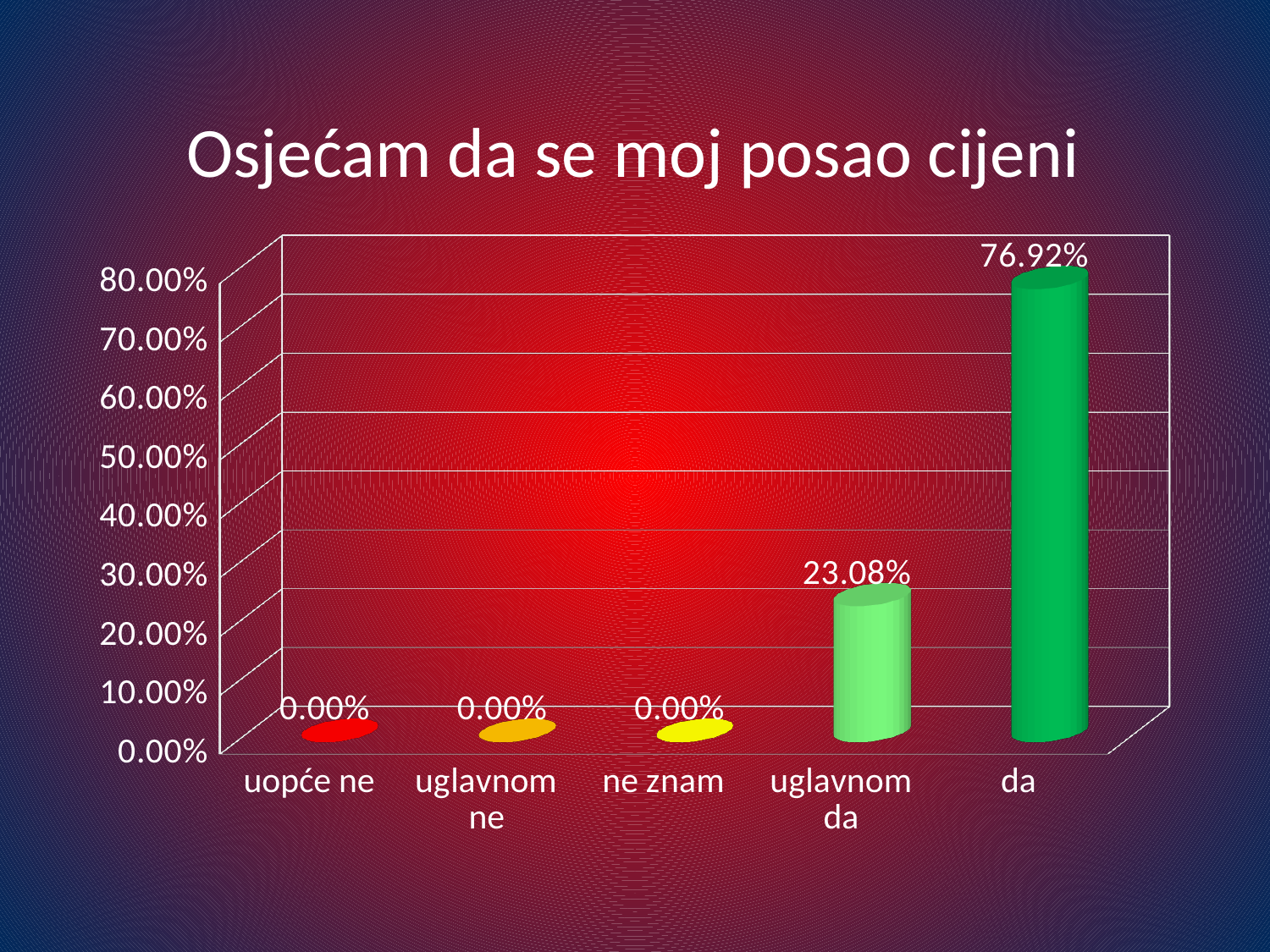
Is the value for "uglavnom da" greater or less than 30.00%? less What is the title of the chart? Osjećam da se moj posao cijeni What is the difference between the values for "da" and "uglavnom da"? 53.84% What is the value for "uglavnom da"? 23.08% How many categories are shown on the x axis? 5 What is the value for "da"? 76.92% Which is larger, the value for "uglavnom da" or the value for "da"? da Which category has the highest value? da What is the value for "ne znam"? 0.00% Do the values rise or fall from left to right along the x axis? rise What kind of chart is shown on the slide? bar chart Is the value for "da" greater or less than 70.00%? greater